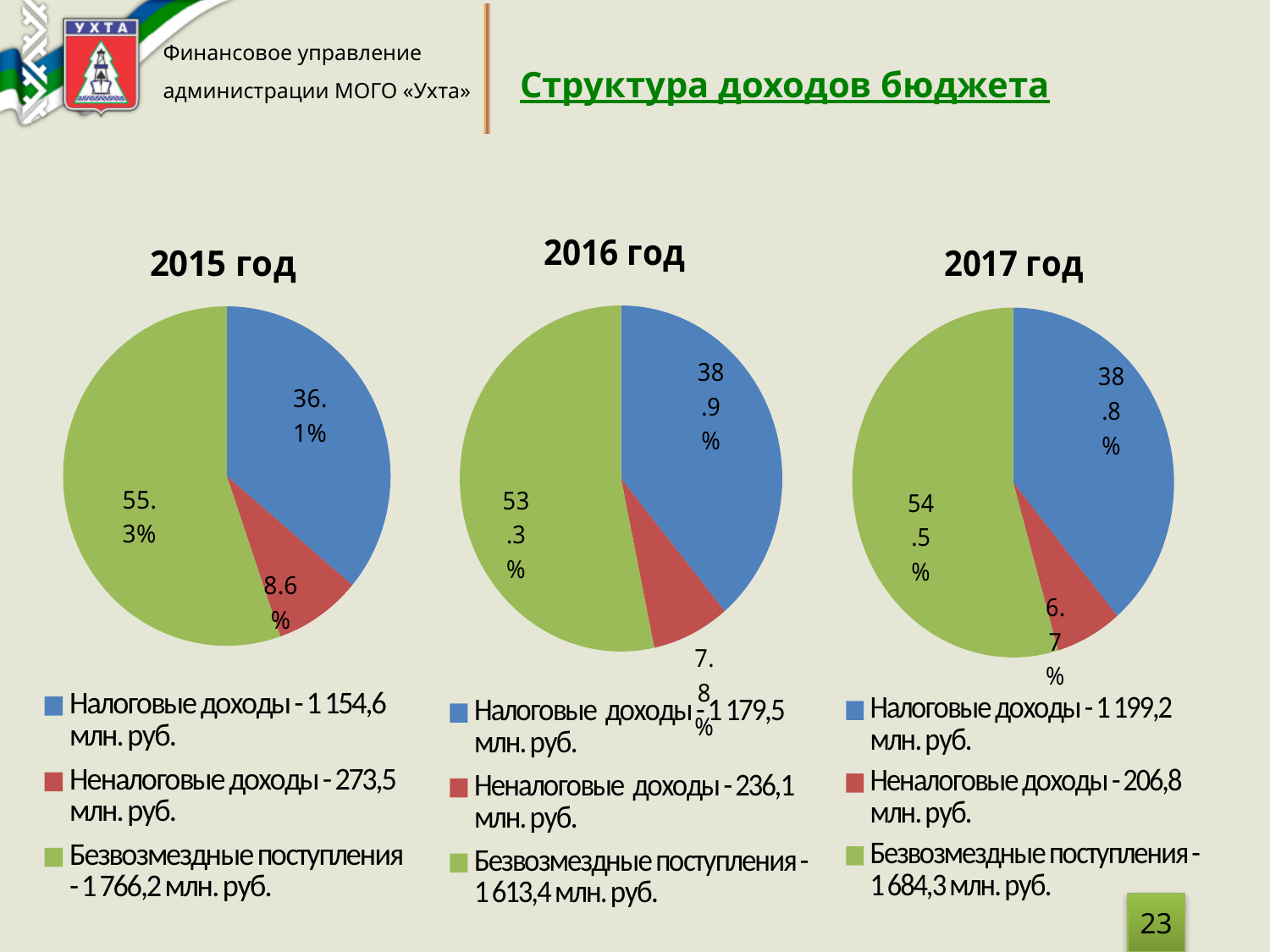
In the 2015 год pie chart, what share does Неналоговые доходы have? 8.6% How many slices does the 2016 год pie chart have? 3 According to the legend of the 2016 год chart, what amount is given for Безвозмездные поступления? 1 613,4 млн. руб. According to the legend of the 2017 год chart, what amount is given for Налоговые доходы? 1 199,2 млн. руб. In the 2015 год pie chart, what is the difference in percentage points between Безвозмездные поступления and Налоговые доходы? 19.2 In the 2015 год pie chart, what share does Безвозмездные поступления have? 55.3% In the 2016 год pie chart, what share does Налоговые доходы have? 38.9% In the 2016 год pie chart, which category has the smallest slice? Неналоговые доходы In the 2017 год pie chart, which category has the largest slice? Безвозмездные поступления What type of chart is used for 2015 год? pie chart In the 2017 год pie chart, is the slice for Налоговые доходы larger or smaller than the slice for Неналоговые доходы? larger